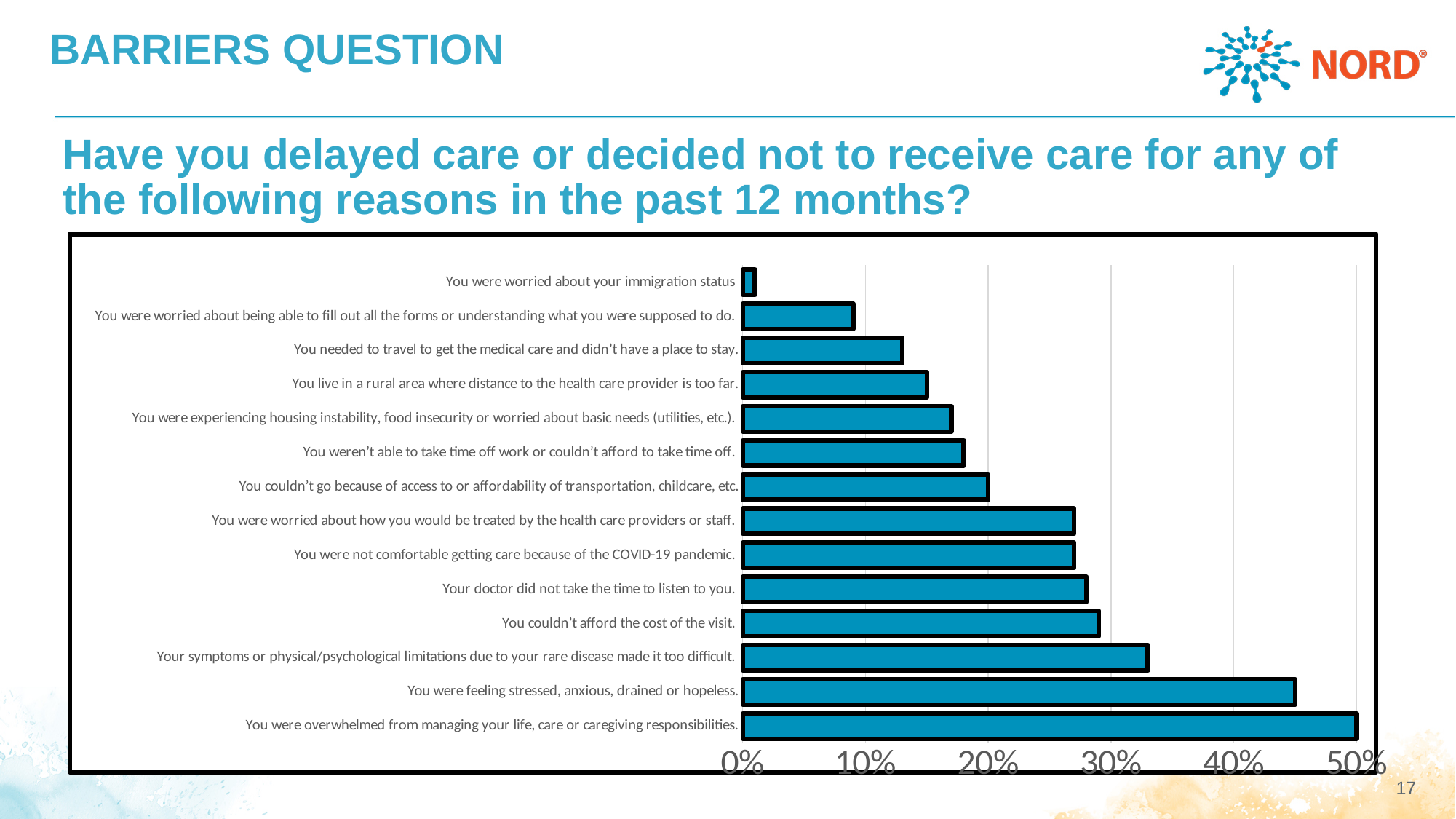
What is the highest value shown on the horizontal axis of the chart? 50% Which reason has the highest value in the chart? You were overwhelmed from managing your life, care or caregiving responsibilities. Is the value for "You were overwhelmed from managing your life, care or caregiving responsibilities." greater or less than 40%? greater Is the value for "You were feeling stressed, anxious, drained or hopeless." greater or less than 40%? greater How many reasons (categories) are plotted in the chart? 14 Is the value for "You live in a rural area where distance to the health care provider is too far." greater or less than 20%? less Which is larger: the value for "You were feeling stressed, anxious, drained or hopeless." or the value for "Your symptoms or physical/psychological limitations due to your rare disease made it too difficult."? You were feeling stressed, anxious, drained or hopeless. What kind of chart is shown on the slide? bar chart Which reason has the lowest value in the chart? You were worried about your immigration status